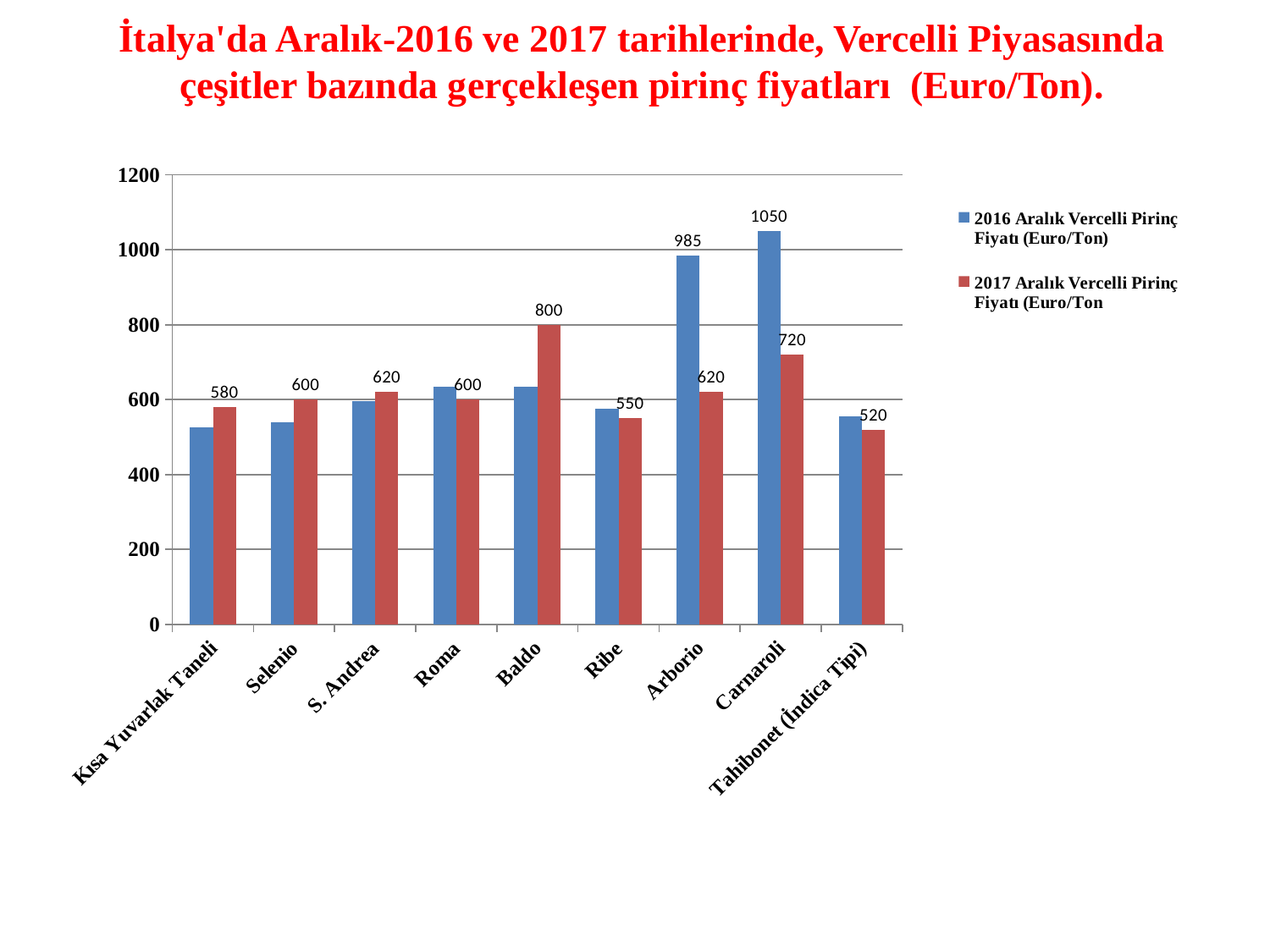
What is the difference between the 2016 and 2017 Aralık prices for Carnaroli? 330 How many series does the legend list? 2 What was the 2017 Aralık Vercelli rice price for Baldo? 800 What is the difference between the 2016 and 2017 Aralık prices for Arborio? 365 Which variety had the highest 2016 Aralık price? Carnaroli Is the 2016 Aralık price for Kısa Yuvarlak Taneli greater or less than 600? less How many rice varieties are shown on the x axis? 9 What was the 2017 Aralık Vercelli rice price for Tahibonet (İndica Tipi)? 520 Which had the higher 2017 Aralık price, Baldo or Arborio? Baldo Which variety had the highest 2017 Aralık price? Baldo Which variety had the lowest 2017 Aralık price? Tahibonet (İndica Tipi) What was the 2016 Aralık Vercelli rice price for Carnaroli? 1050